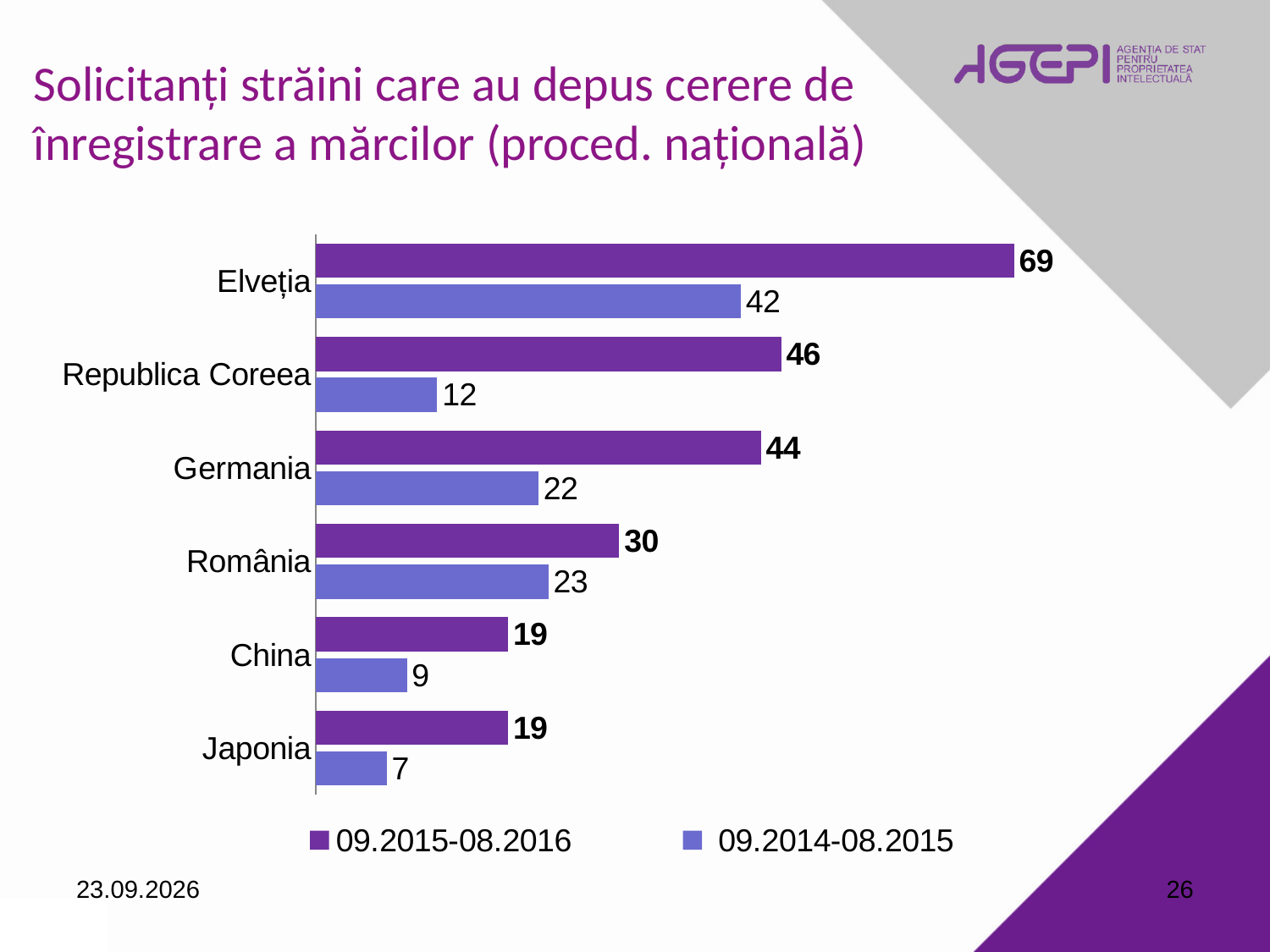
How many countries are shown on the chart? 6 What is the value for Japonia in the 09.2014-08.2015 series? 7 Which is larger: the 09.2014-08.2015 value for România or the 09.2014-08.2015 value for Germania? România What is the value for Germania in the 09.2015-08.2016 series? 44 How many series does the legend list? 2 What is the difference between the 09.2015-08.2016 and 09.2014-08.2015 values for Republica Coreea? 34 What is the value for Republica Coreea in the 09.2014-08.2015 series? 12 Which country has the lowest value in the 09.2014-08.2015 series? Japonia Which country has the highest value in the 09.2015-08.2016 series? Elveția What is the value for Elveția in the 09.2015-08.2016 series? 69 What kind of chart is shown on the slide? Bar chart Which series is shown in the darker purple colour? 09.2015-08.2016